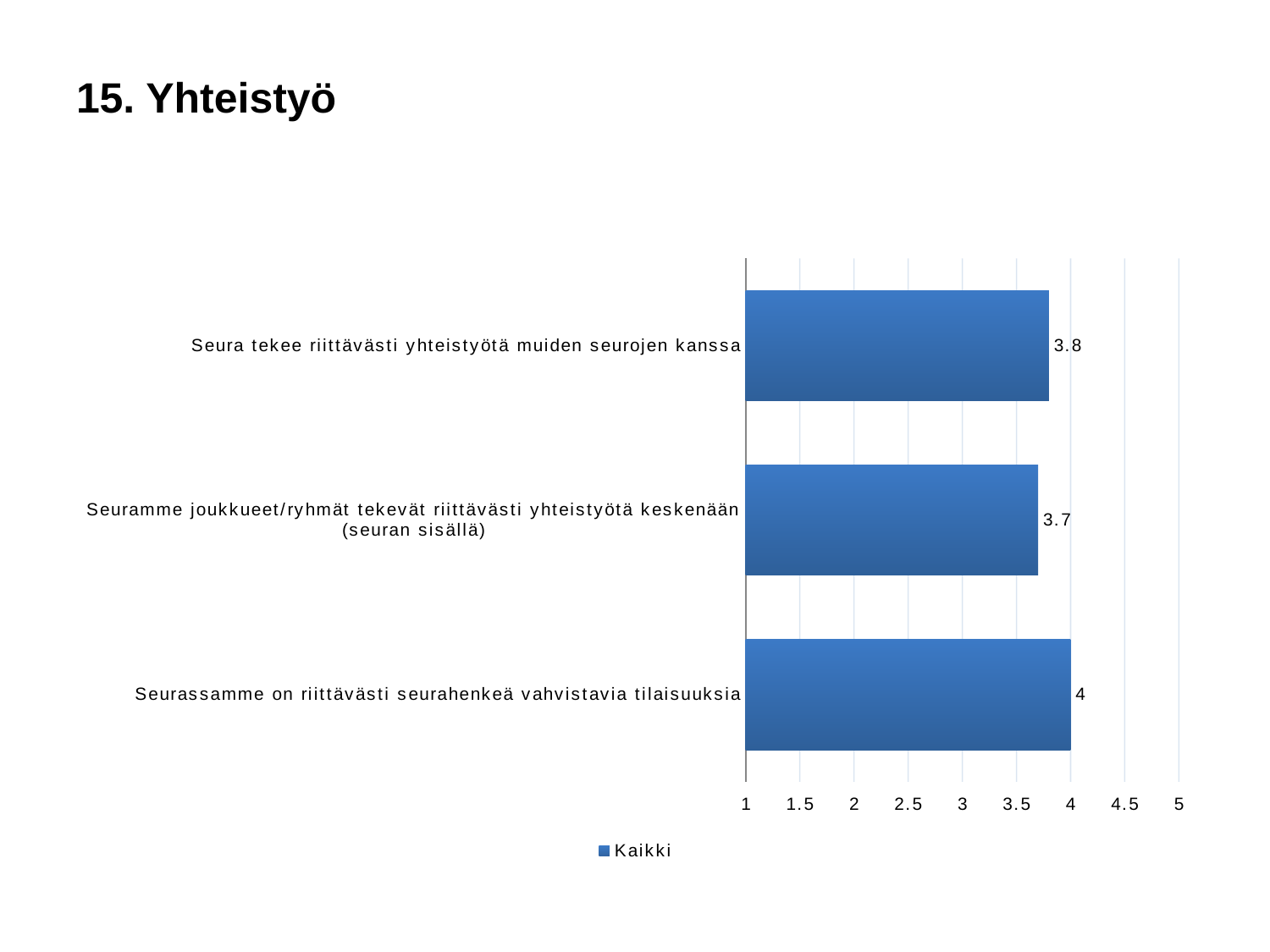
What kind of chart is shown on the slide? bar chart What is the name of the series shown in the legend? Kaikki What is the value for "Seurassamme on riittävästi seurahenkeä vahvistavia tilaisuuksia"? 4 How many categories are shown in the chart? 3 Which is larger: the value for "Seura tekee riittävästi yhteistyötä muiden seurojen kanssa" or the value for "Seurassamme on riittävästi seurahenkeä vahvistavia tilaisuuksia"? Seurassamme on riittävästi seurahenkeä vahvistavia tilaisuuksia What is the value for "Seura tekee riittävästi yhteistyötä muiden seurojen kanssa"? 3.8 Which category has the lowest value? Seuramme joukkueet/ryhmät tekevät riittävästi yhteistyötä keskenään (seuran sisällä) What is the value for "Seuramme joukkueet/ryhmät tekevät riittävästi yhteistyötä keskenään (seuran sisällä)"? 3.7 Which category has the highest value? Seurassamme on riittävästi seurahenkeä vahvistavia tilaisuuksia Is the value for "Seura tekee riittävästi yhteistyötä muiden seurojen kanssa" greater or less than 3.5? greater What is the difference between the value for "Seurassamme on riittävästi seurahenkeä vahvistavia tilaisuuksia" and the value for "Seuramme joukkueet/ryhmät tekevät riittävästi yhteistyötä keskenään (seuran sisällä)"? 0.3 How many series does the legend list? 1